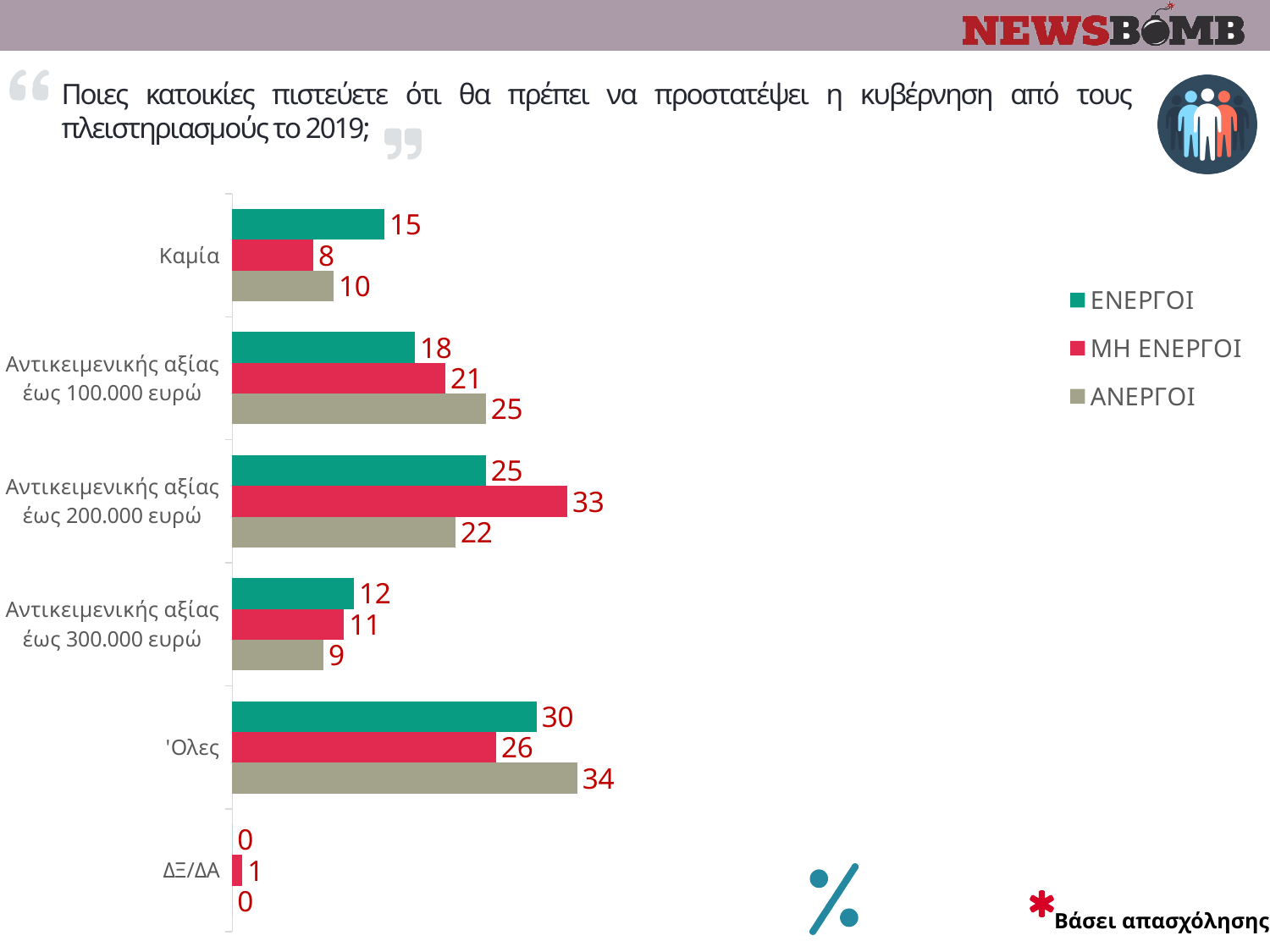
How many series does the legend list? 3 What is the value for ΜΗ ΕΝΕΡΓΟΙ in the category Αντικειμενικής αξίας έως 200.000 ευρώ? 33 Which category has the lowest value for the ΑΝΕΡΓΟΙ series? ΔΞ/ΔΑ What kind of chart is shown on the slide? Bar chart What is the value for ΜΗ ΕΝΕΡΓΟΙ in the category ΔΞ/ΔΑ? 1 Which category has the highest value for the ΕΝΕΡΓΟΙ series? Όλες What is the value for ΑΝΕΡΓΟΙ in the category Όλες? 34 Which series is shown in green in the legend? ΕΝΕΡΓΟΙ What is the value for ΕΝΕΡΓΟΙ in the category Καμία? 15 How many categories are shown on the chart? 6 What is the difference between the ΜΗ ΕΝΕΡΓΟΙ and ΕΝΕΡΓΟΙ values in the category Αντικειμενικής αξίας έως 200.000 ευρώ? 8 In the category Αντικειμενικής αξίας έως 100.000 ευρώ, which series has the larger value, ΕΝΕΡΓΟΙ or ΑΝΕΡΓΟΙ? ΑΝΕΡΓΟΙ